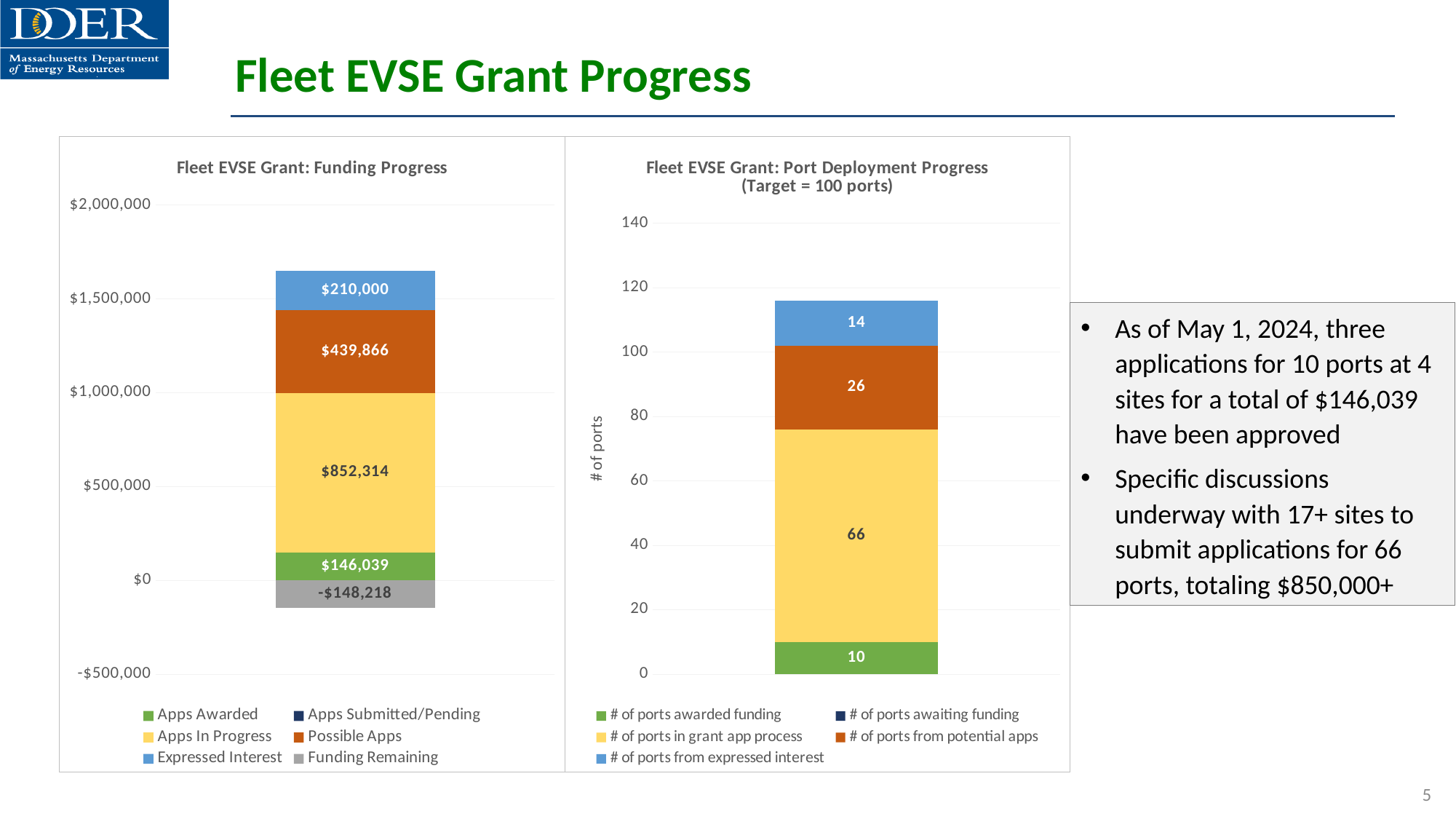
In the Fleet EVSE Grant: Funding Progress chart, what is the value for Funding Remaining? -$148,218 In the Fleet EVSE Grant: Funding Progress chart, how many series does the legend list? 6 In the Fleet EVSE Grant: Port Deployment Progress chart, what is the total number of ports in the stacked bar? 116 In the Fleet EVSE Grant: Port Deployment Progress chart, how many ports are from expressed interest? 14 In the Fleet EVSE Grant: Port Deployment Progress chart, how many ports are in the grant app process? 66 In the Fleet EVSE Grant: Port Deployment Progress chart, what is the difference between # of ports in grant app process and # of ports from potential apps? 40 In the Fleet EVSE Grant: Port Deployment Progress chart, which is larger: # of ports from potential apps or # of ports awarded funding? # of ports from potential apps In the Fleet EVSE Grant: Funding Progress chart, which series has the largest value? Apps In Progress In the Fleet EVSE Grant: Funding Progress chart, what is the value for Expressed Interest? $210,000 In the Fleet EVSE Grant: Funding Progress chart, what is the difference between Apps In Progress and Possible Apps? $412,448 In the Fleet EVSE Grant: Funding Progress chart, what is the value for Apps In Progress? $852,314 What type of chart is the Fleet EVSE Grant: Port Deployment Progress chart? Stacked bar chart